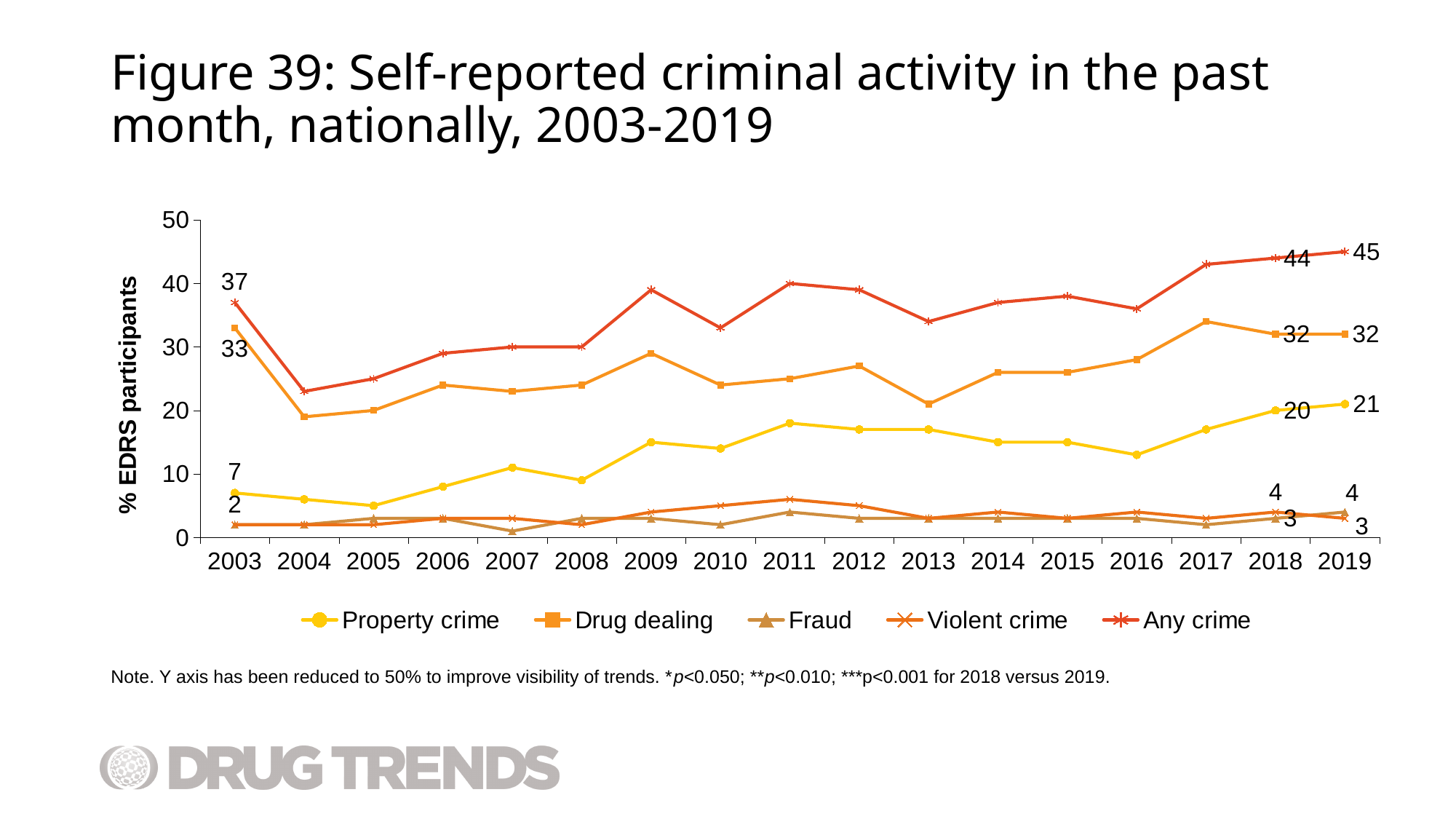
Is the value for Any crime in 2004 greater or less than 20? greater What is the value for Any crime in 2003? 37 How many series does the legend list? 5 What is the value for Drug dealing in 2003? 33 What is the difference between Property crime in 2019 and in 2018? 1 Which series has the highest value in 2019? Any crime What is the value for Property crime in 2018? 20 What is the label on the y axis? % EDRS participants How many years are plotted along the x axis? 17 By how much did Any crime increase from 2003 to 2019? 8 What is the value for Any crime in 2019? 45 What type of chart is shown on the slide? line chart